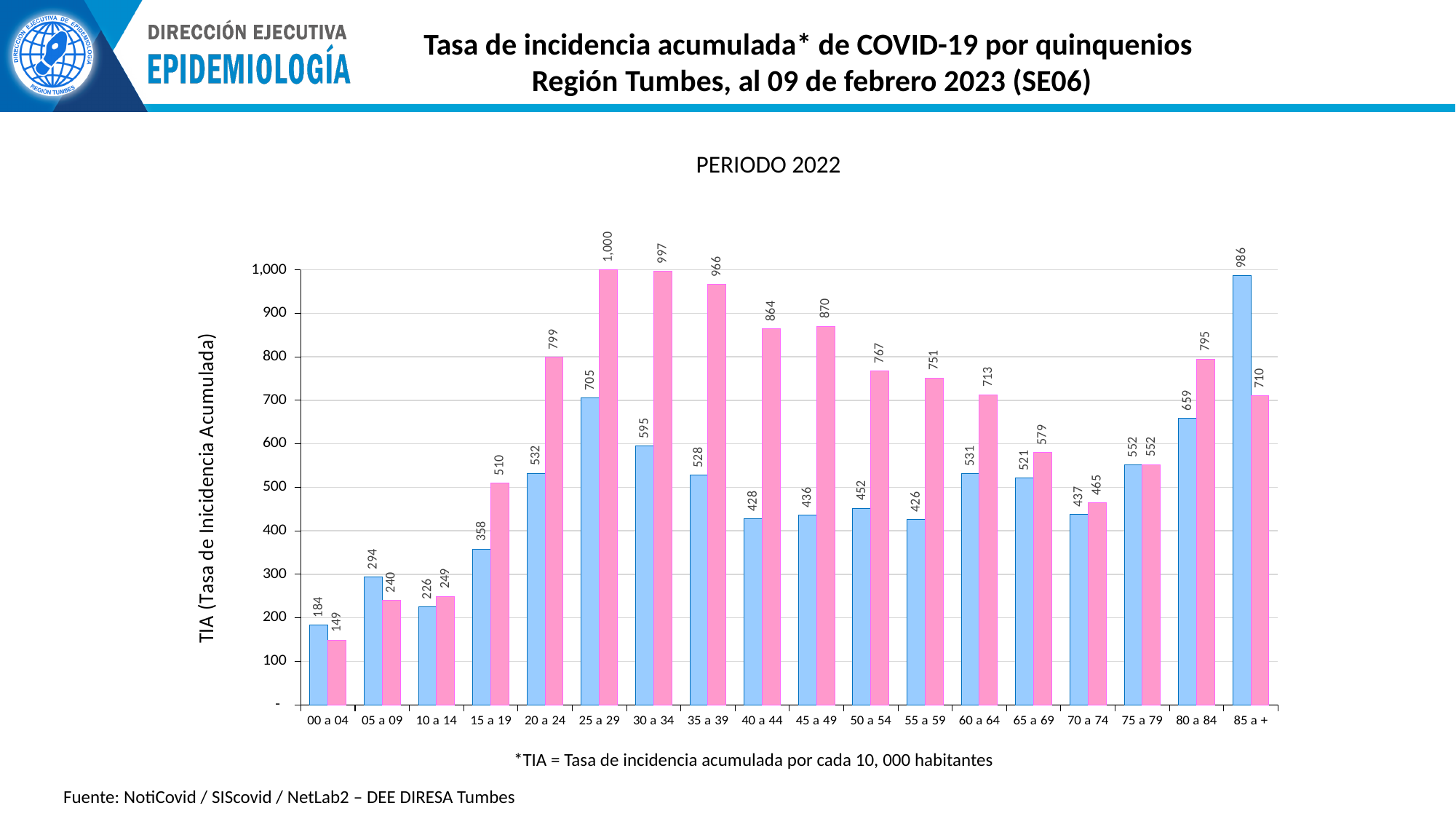
For the 10 a 14 age group, which bar is larger, blue or pink? pink Which age group has the highest pink bar? 25 a 29 Which age group has the lowest blue bar? 00 a 04 What is the value of the pink bar for the 40 a 44 age group? 864 What is the difference between the pink and blue bars for the 85 a + age group? 276 Which age group has the highest blue bar? 85 a + What is the value of the blue bar for the 25 a 29 age group? 705 What is the value of the pink bar for the 75 a 79 age group? 552 What is the difference between the blue bars for 80 a 84 and 75 a 79? 107 How many age groups are shown on the x axis? 18 What is the title shown above the chart? PERIODO 2022 What kind of chart is shown on the slide? bar chart